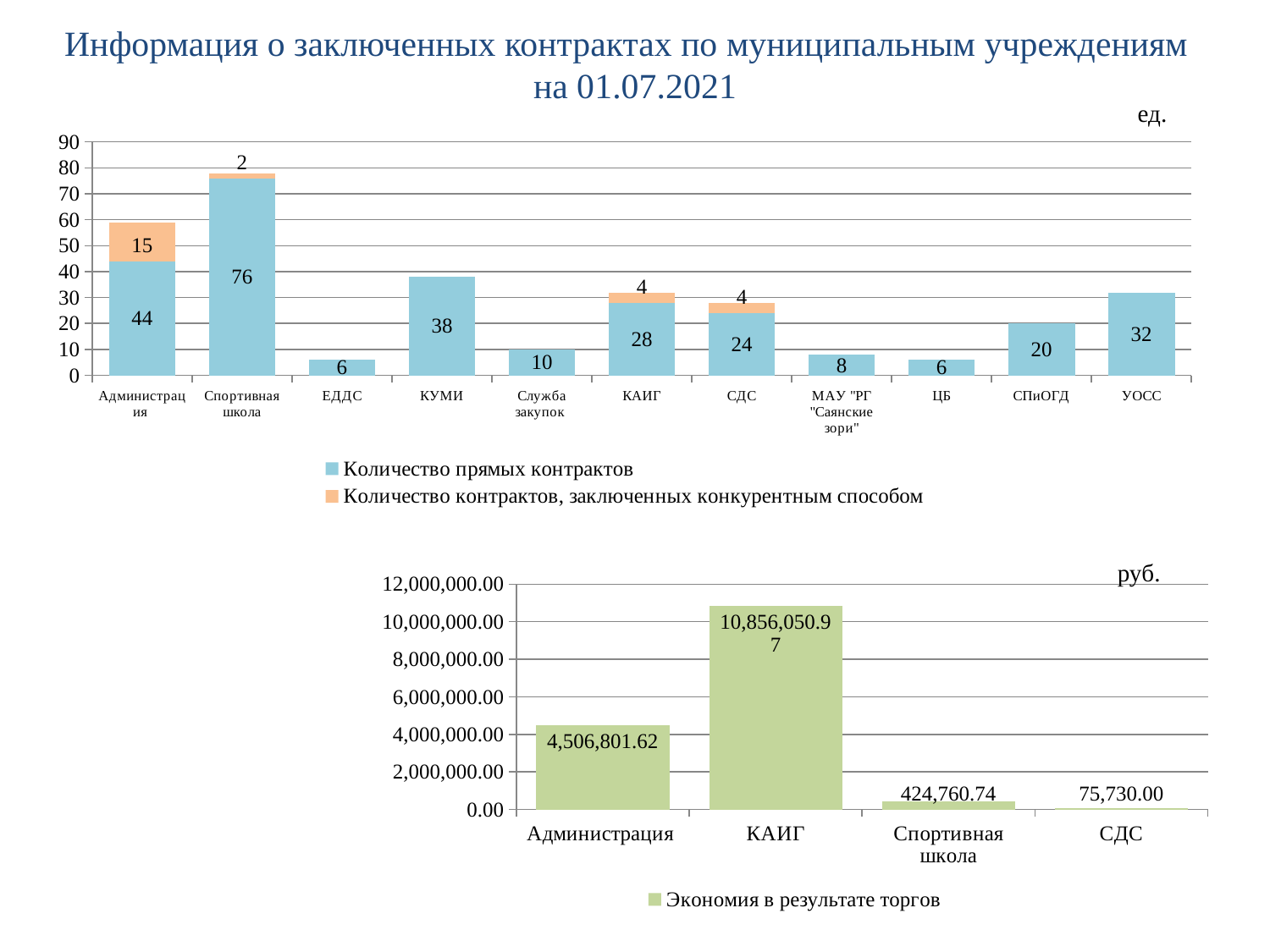
In the bottom chart, which category has the lowest value? СДС In the top chart, what is the total height of the stacked bar for Администрация? 59 In the top chart, what is the difference between the direct contracts of КУМИ and УОСС? 6 In the top chart, which category has the highest number of direct contracts? Спортивная школа In the top chart, how many series does the legend list? 2 In the bottom chart, what is the value for КАИГ? 10,856,050.97 In the top chart, what is the total height of the stacked bar for КАИГ? 32 In the top chart, which has more direct contracts, СДС or СПиОГД? СДС What kind of chart is the bottom chart? Bar chart In the top chart, how many categories are shown on the x axis? 11 In the top chart, how many contracts concluded by competitive method (Количество контрактов, заключенных конкурентным способом) does Администрация have? 15 In the top chart, how many direct contracts (Количество прямых контрактов) does Спортивная школа have? 76